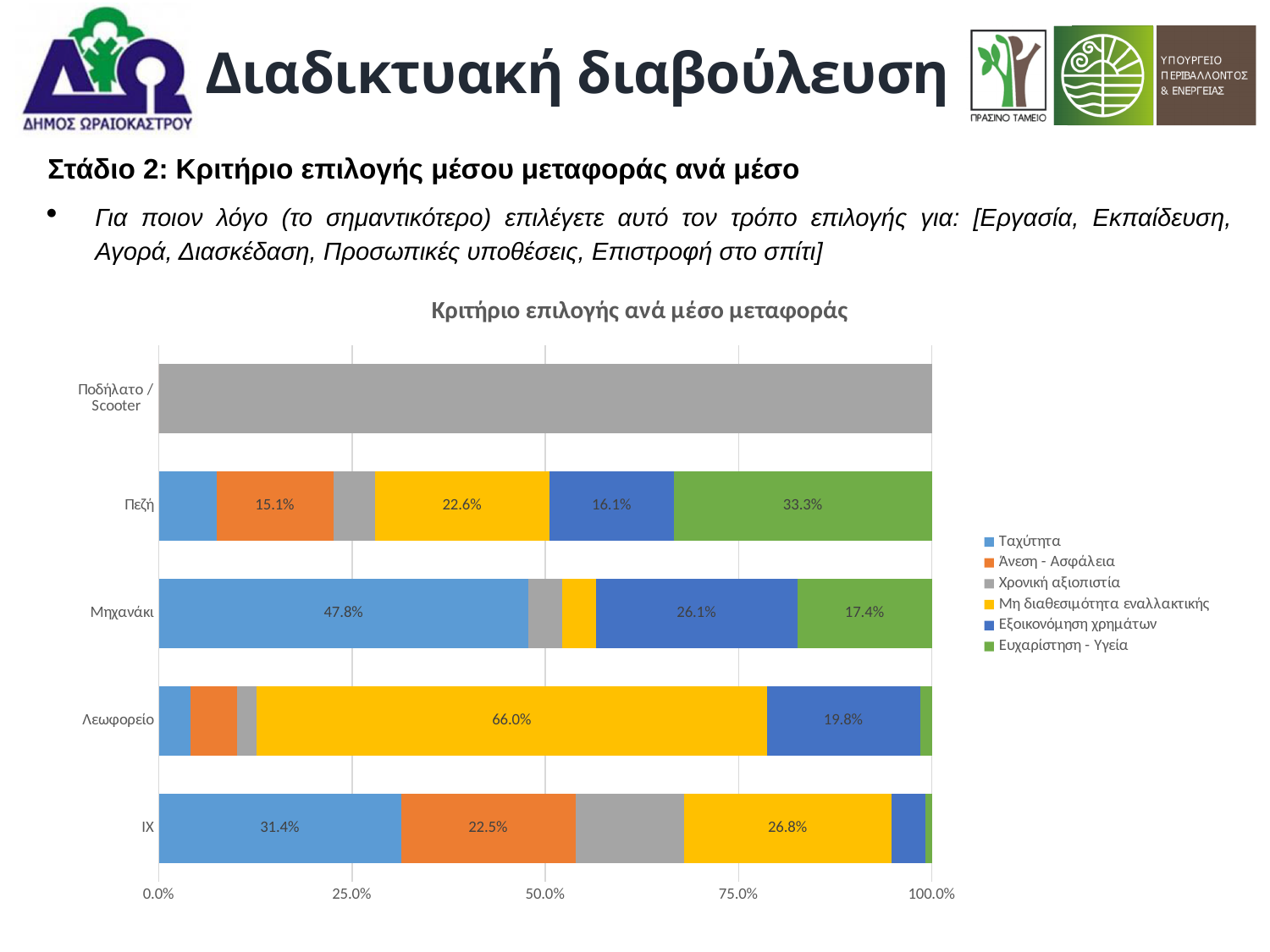
What is the difference between Ευχαρίστηση - Υγεία (33.3%) and Άνεση - Ασφάλεια (15.1%) for Πεζή? 18.2 percentage points What is the value of Μη διαθεσιμότητα εναλλακτικής for Λεωφορείο? 66.0% What is the value of Άνεση - Ασφάλεια for ΙΧ? 22.5% Which transport mode has the largest share for Μη διαθεσιμότητα εναλλακτικής? Λεωφορείο How many transport modes (categories) are shown on the vertical axis of the chart? 5 What is the title of the chart? Κριτήριο επιλογής ανά μέσο μεταφοράς How many series does the chart legend list? 6 What is the value of Ταχύτητα for Μηχανάκι? 47.8% Which is larger: Εξοικονόμηση χρημάτων for Μηχανάκι or for Λεωφορείο? Μηχανάκι Is the share of Χρονική αξιοπιστία for Ποδήλατο / Scooter greater or less than 75.0%? greater What type of chart is shown on the slide? Stacked bar chart What is the value of Ευχαρίστηση - Υγεία for Πεζή? 33.3%